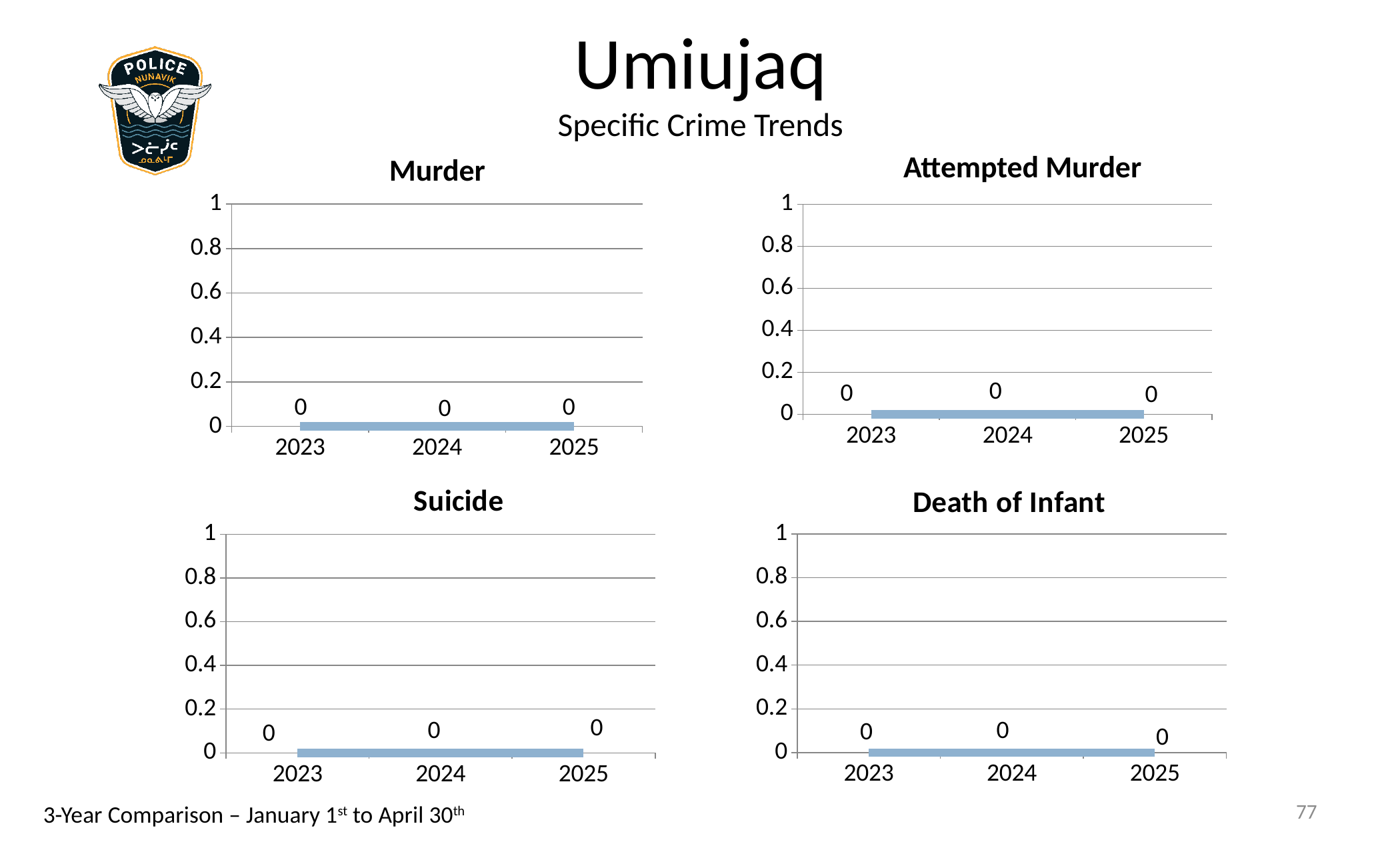
In the Death of Infant chart, what is the value for 2023? 0 How many categories are shown on the x axis of the Suicide chart? 3 In the Attempted Murder chart, what is the value for 2024? 0 How many charts are shown on the slide? 4 What is the title of the chart in the top-right position of the slide? Attempted Murder In the Suicide chart, what is the value for 2025? 0 In the Attempted Murder chart, do the values rise, fall, or stay flat from 2023 to 2025? Stay flat In the Death of Infant chart, what is the highest value shown on the y axis? 1 In the Murder chart, what is the difference between the values for 2025 and 2023? 0 What kind of chart is the Death of Infant chart? Line chart In the Murder chart, what is the value for 2023? 0 In the Suicide chart, is the value for 2024 greater or less than 0.2? less